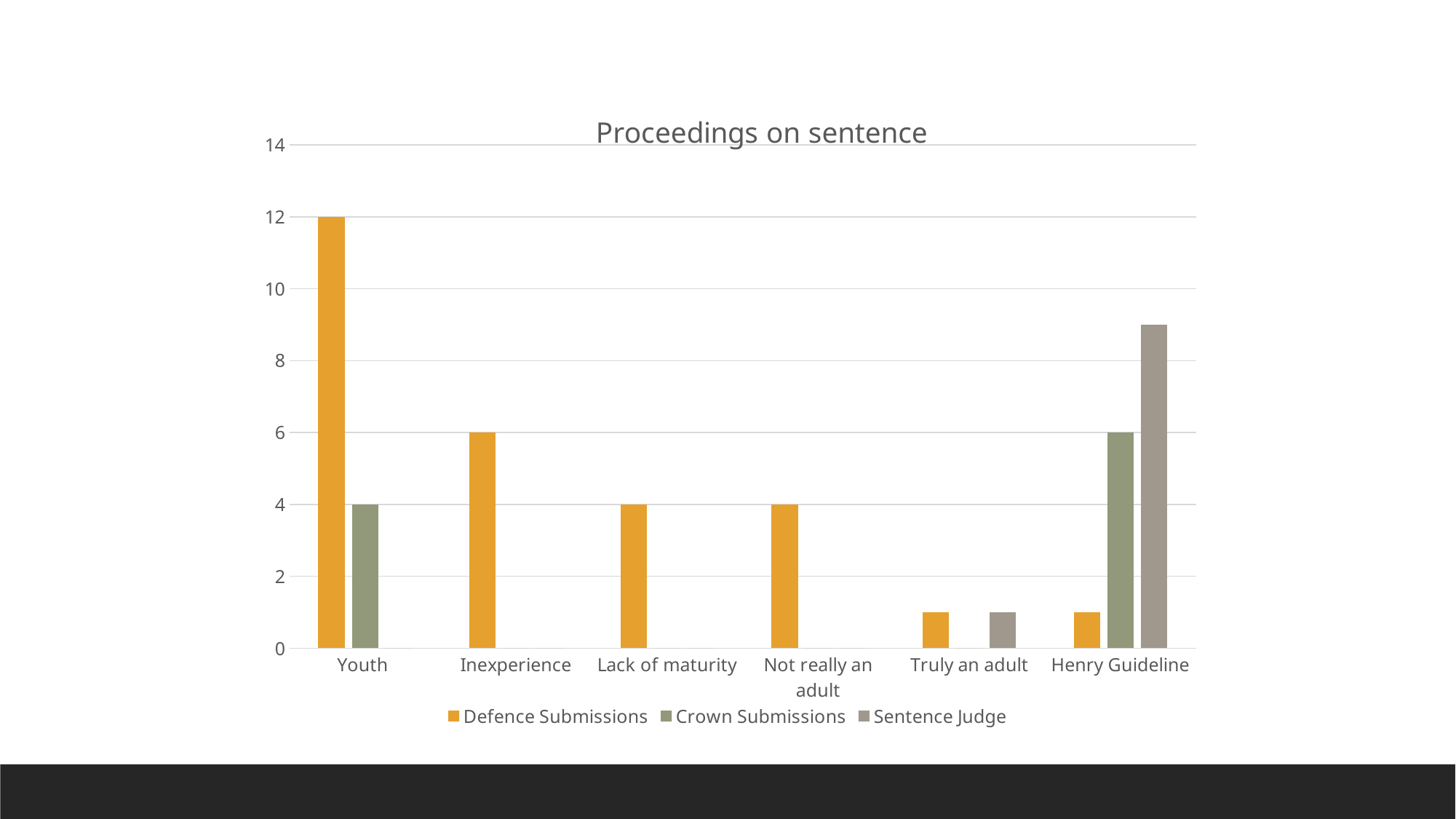
What kind of chart is shown on the slide? bar chart What is the title of the chart? Proceedings on sentence How many series does the legend list? 3 Is the Sentence Judge value for Henry Guideline greater or less than 8? greater How many categories are shown on the x axis? 6 What is the Defence Submissions value for Inexperience? 6 What is the difference between the Defence Submissions and Crown Submissions values for Youth? 8 What is the Defence Submissions value for Youth? 12 Which category has the highest Defence Submissions value? Youth What is the Crown Submissions value for Henry Guideline? 6 Which has the larger Crown Submissions value, Youth or Henry Guideline? Henry Guideline What is the Crown Submissions value for Youth? 4